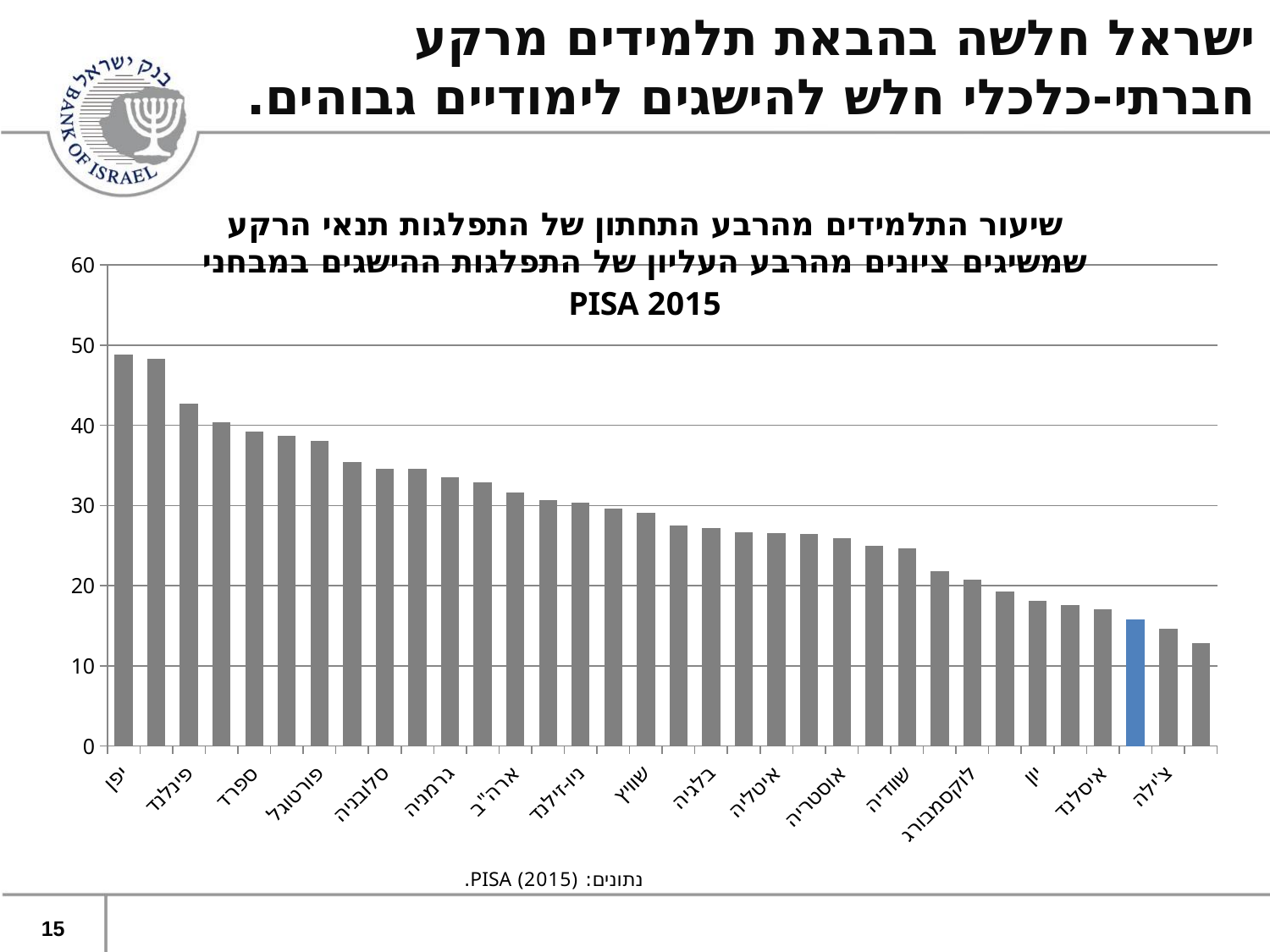
What kind of chart is shown on the slide? bar chart Do the bar values rise or fall from left to right along the x axis? fall Is the value for פורטוגל greater or less than 30? greater Is the value for פינלנד greater or less than 40? greater Is the value for שוודיה greater or less than 20? greater Which has a higher value, יפן or צ'ילה? יפן